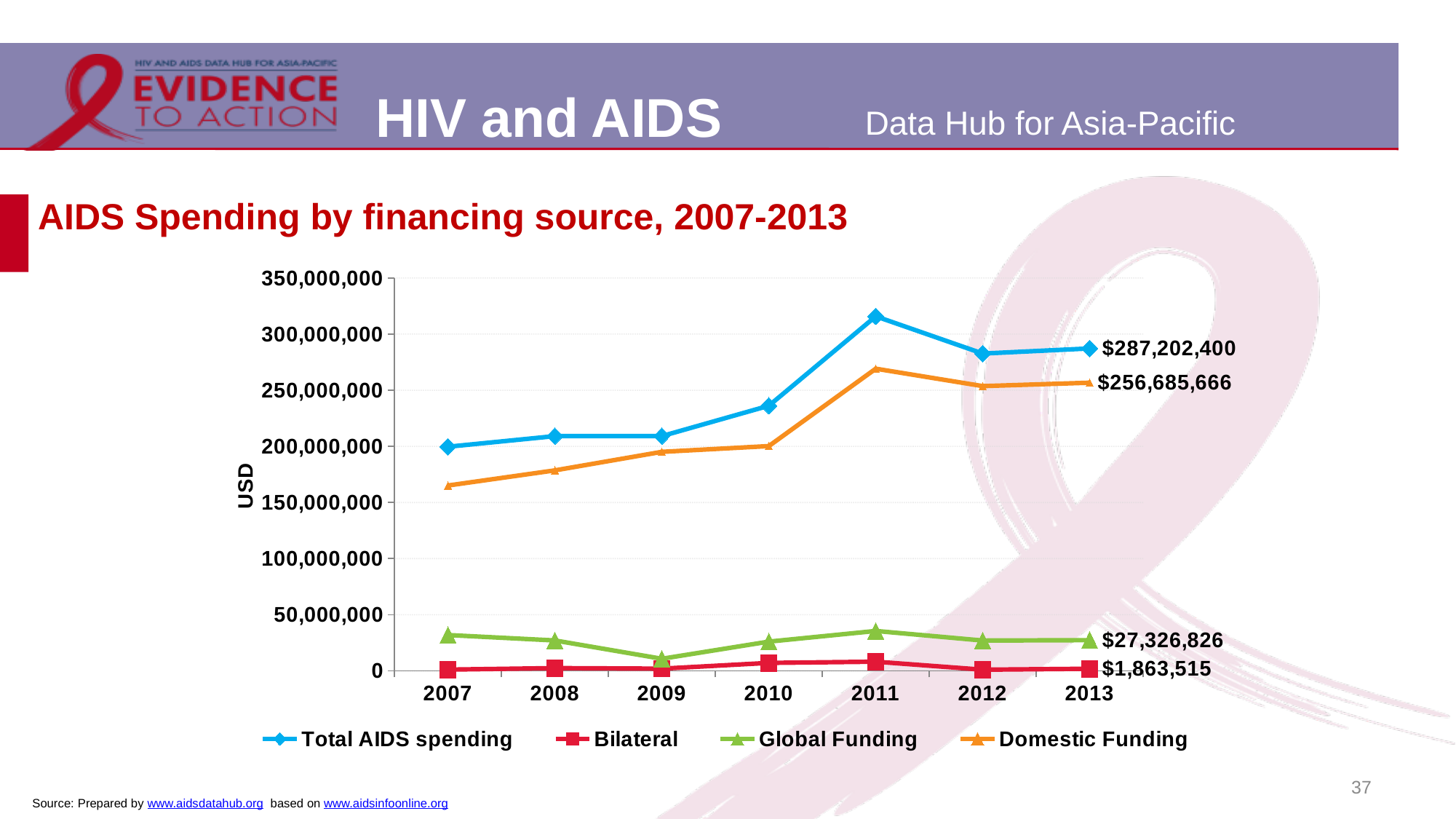
What is the value for Domestic Funding in 2013? $256,685,666 In which year is Total AIDS spending highest? 2011 What kind of chart is shown on the slide? line chart Is the value for Domestic Funding in 2007 greater or less than 150,000,000? greater What is the value for Bilateral in 2013? $1,863,515 What is the value for Total AIDS spending in 2013? $287,202,400 How many series does the legend list? 4 In which year is Global Funding lowest? 2009 What is the value for Global Funding in 2013? $27,326,826 How many years are shown on the x axis? 7 Is the value for Total AIDS spending in 2011 greater or less than 300,000,000? greater What is the difference between Total AIDS spending and Domestic Funding in 2013? $30,516,734